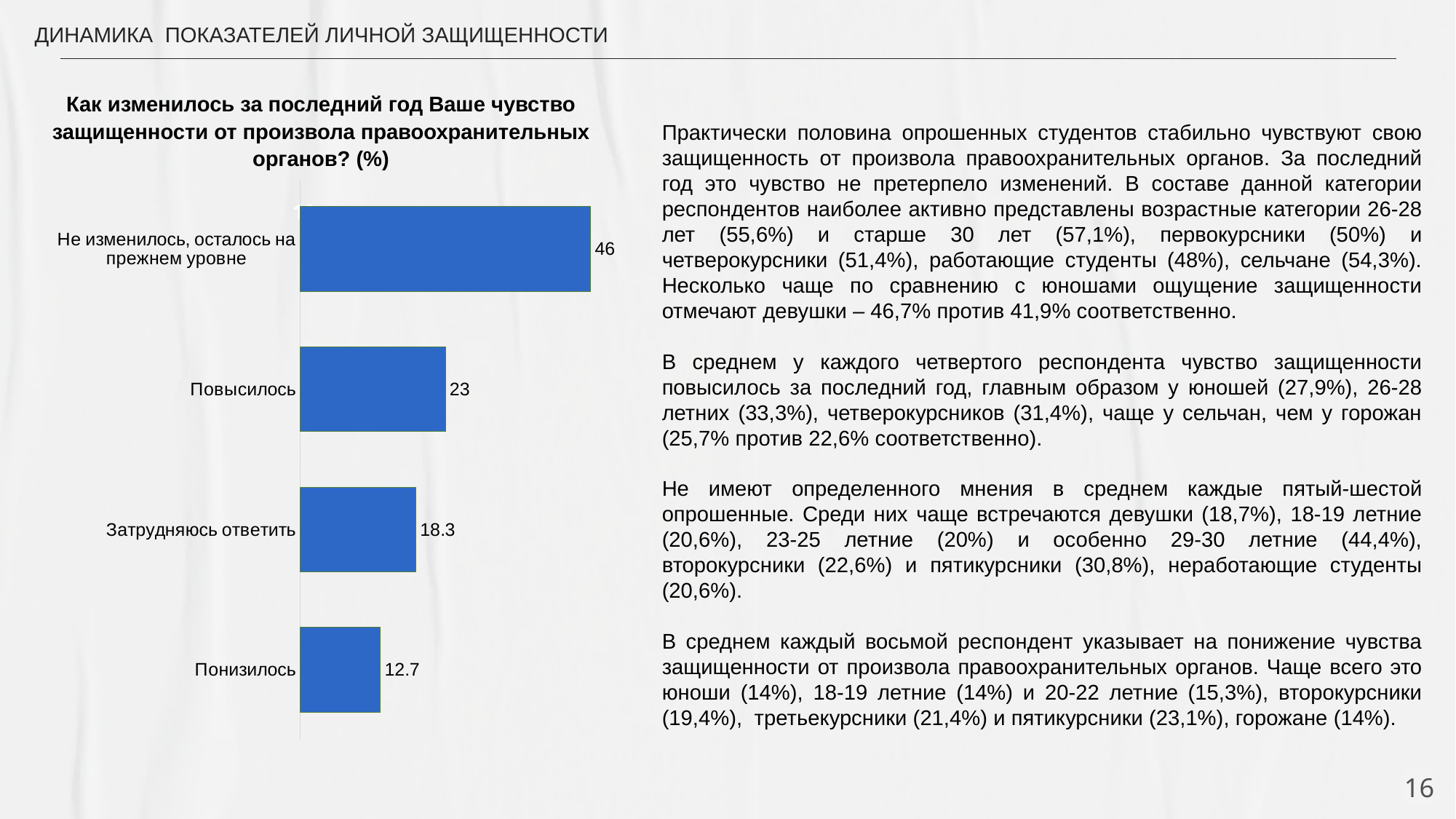
Which is larger: the value for "Затрудняюсь ответить" or the value for "Понизилось"? Затрудняюсь ответить What kind of chart is shown on the slide? Bar chart Which category has the highest value? Не изменилось, осталось на прежнем уровне What is the value for "Не изменилось, осталось на прежнем уровне"? 46 What is the value for "Затрудняюсь ответить"? 18.3 How many categories are shown in the chart? 4 What is the value for "Понизилось"? 12.7 Which category has the lowest value? Понизилось What colour are the bars in the chart? Blue What is the value for "Повысилось"? 23 What is the difference between the values for "Повысилось" and "Понизилось"? 10.3 What is the difference between the values for "Не изменилось, осталось на прежнем уровне" and "Повысилось"? 23